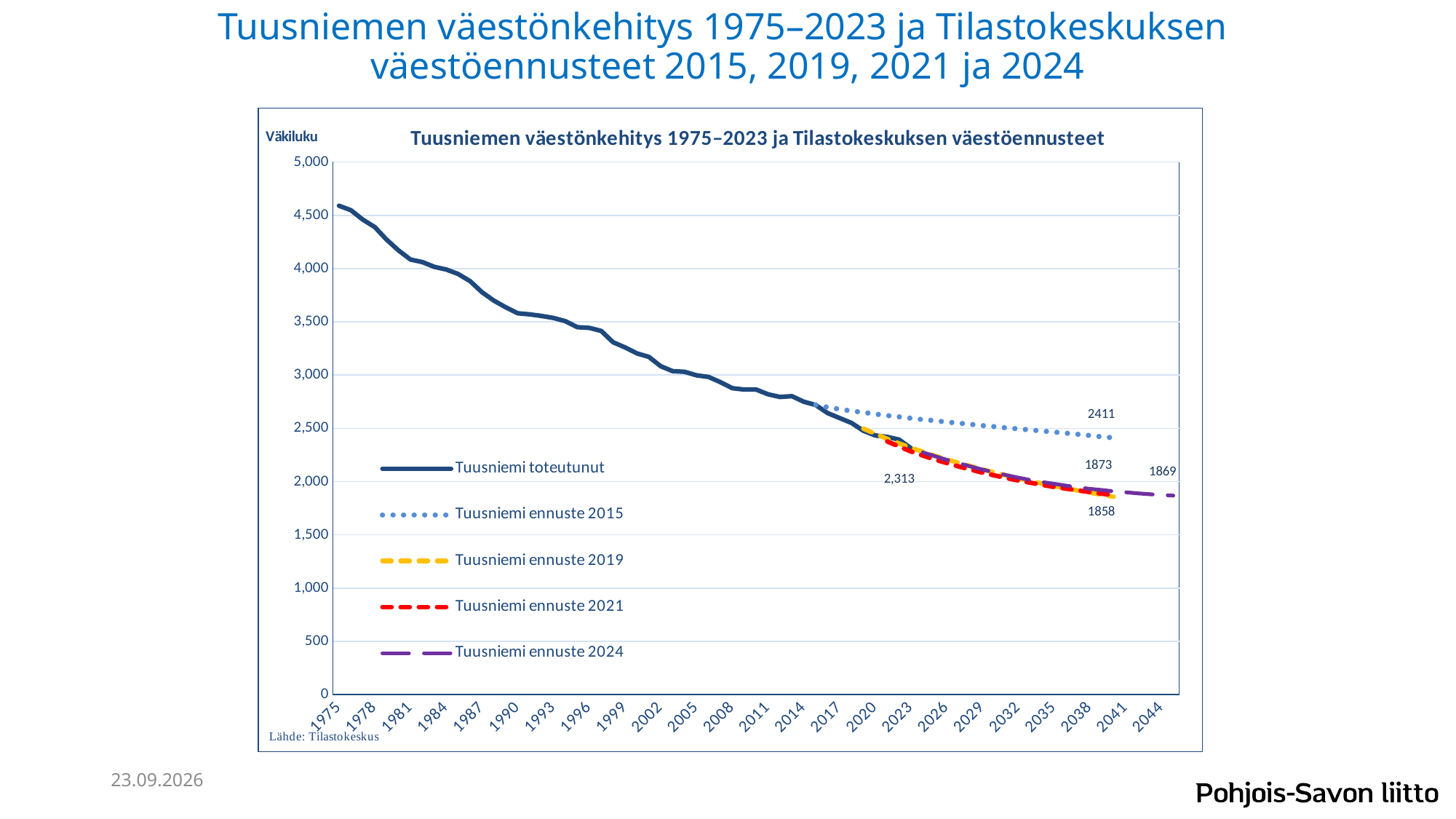
What is the difference between the final labelled value of ennuste 2015 (2411) and the final labelled value of ennuste 2024 (1869)? 542 What is the label on the vertical axis of the chart? Väkiluku Is the value of Tuusniemi toteutunut in 1975 greater or less than 4,500? greater What is the labelled value of the Tuusniemi toteutunut series at its end point (2023)? 2,313 What is the final labelled value of the Tuusniemi ennuste 2024 series? 1869 Does the Tuusniemi toteutunut series rise or fall from 1975 to 2023? fall How many series does the legend list? 5 What colour is the Tuusniemi ennuste 2021 line in the legend? red What is the final labelled value of the Tuusniemi ennuste 2015 series? 2411 Which ends at a higher value: the Tuusniemi ennuste 2015 series or the Tuusniemi ennuste 2024 series? Tuusniemi ennuste 2015 Is the value of Tuusniemi toteutunut in 2005 greater or less than 3,500? less What kind of chart is shown on the slide? line chart